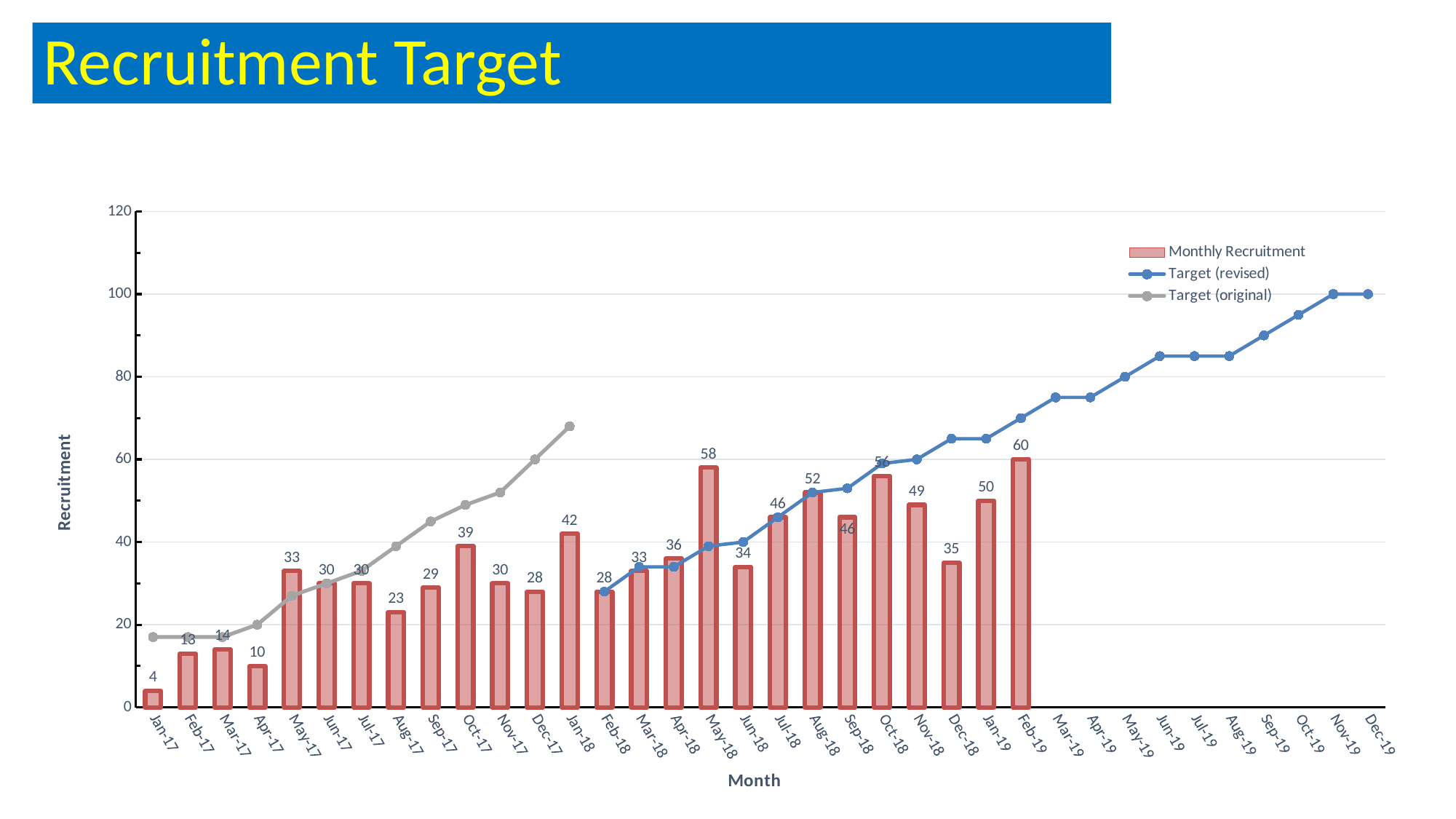
How many series does the legend list? 3 Is the Target (original) value for Sep-17 greater or less than 40? greater What is the Monthly Recruitment value for Oct-18? 56 How many months have a Monthly Recruitment bar? 26 Which month has the highest Monthly Recruitment bar? Feb-19 What is the difference between the Monthly Recruitment values for Feb-19 and Jan-19? 10 Which is larger, the Monthly Recruitment for Jan-18 or for Dec-18? Jan-18 What is the Monthly Recruitment value for May-18? 58 Which month has the lowest Monthly Recruitment bar? Jan-17 Is the Target (revised) value for Jun-19 greater or less than 80? greater Does the Target (revised) line rise or fall from Feb-18 to Dec-19? rise What is the Monthly Recruitment value for Jan-17? 4